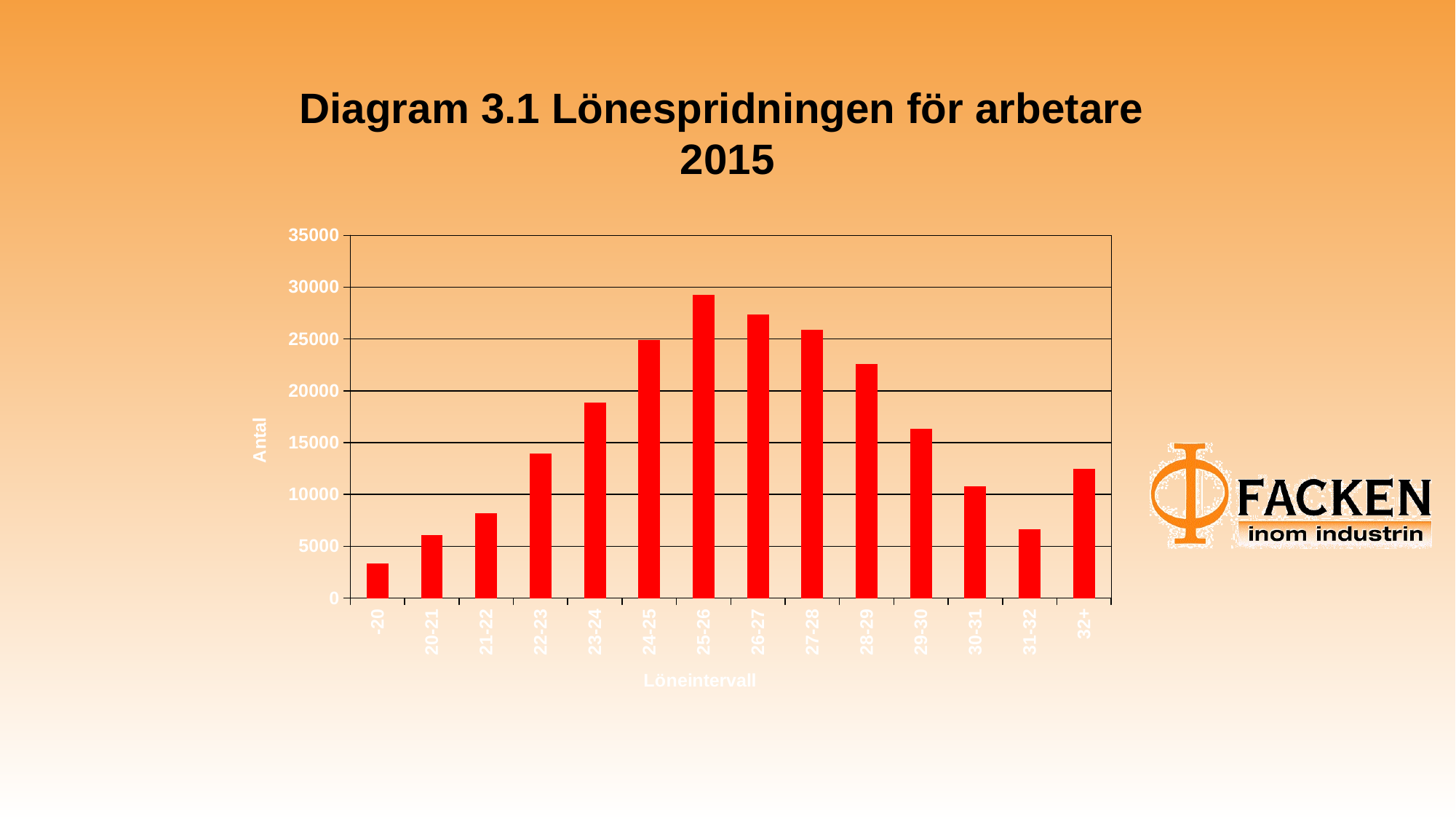
Which has more workers, the 29-30 interval or the 30-31 interval? 29-30 Do the values rise or fall from the -20 interval to the 25-26 interval? rise What kind of chart is shown on the slide? Bar chart Which has more workers, the 24-25 interval or the 28-29 interval? 24-25 Is the value for the 23-24 interval greater or less than 20000? less Which wage interval has the highest number of workers? 25-26 How many wage intervals (categories) are shown on the x axis? 14 Is the value for the 32+ interval greater or less than 10000? greater Which wage interval has the lowest number of workers? -20 What is the label of the vertical axis? Antal Is the value for the 25-26 interval greater or less than 25000? greater